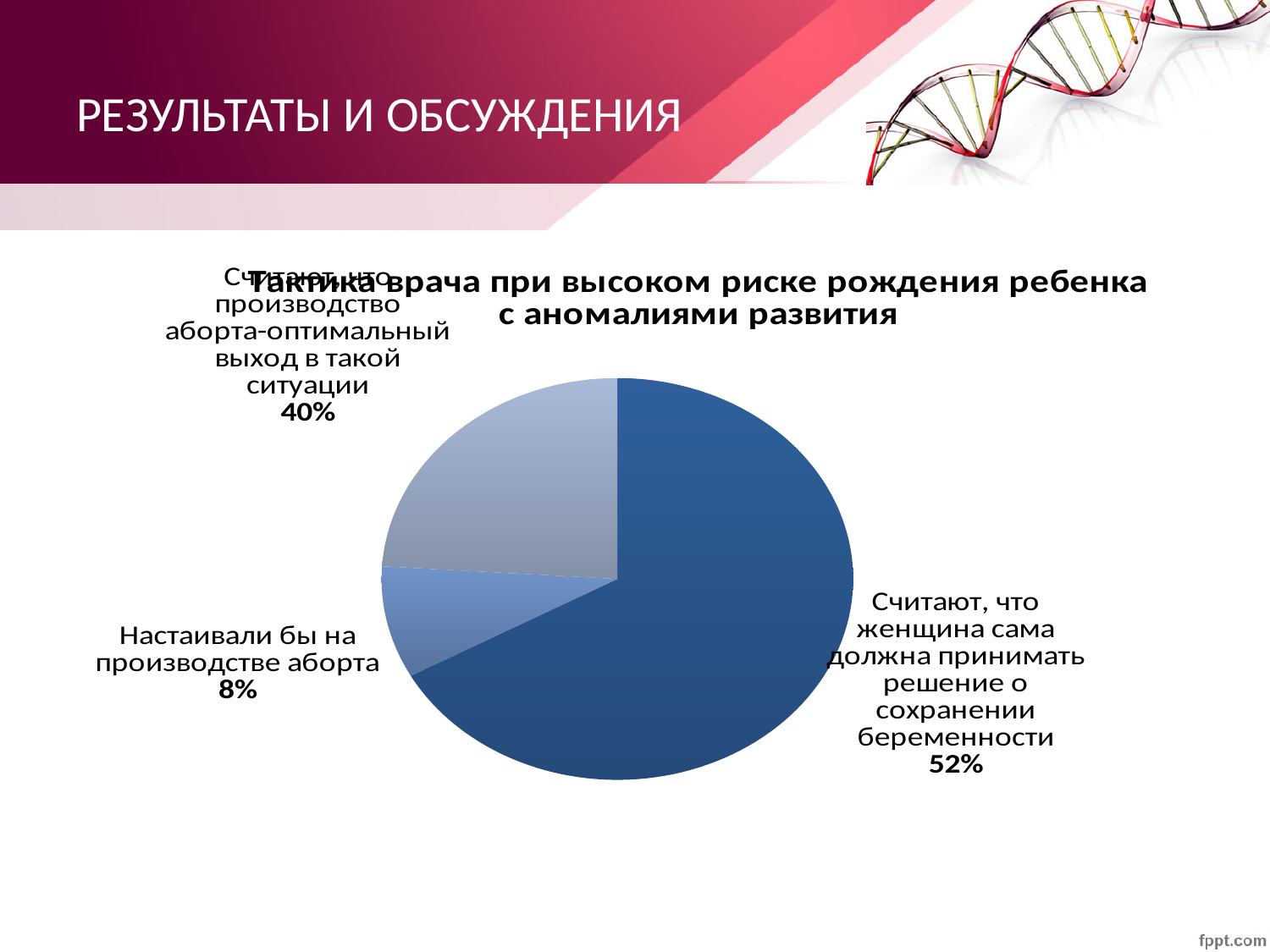
What is the difference in percentage points between the 40% slice and the 8% slice? 32 Which is larger: the share for 'Считают, что женщина сама должна принимать решение о сохранении беременности' or the share for 'Настаивали бы на производстве аборта'? Считают, что женщина сама должна принимать решение о сохранении беременности Which category has the largest share of the pie? Считают, что женщина сама должна принимать решение о сохранении беременности Which category has the smallest share of the pie? Настаивали бы на производстве аборта What percentage is shown for those who consider abortion the optimal way out in such a situation (Считают, что производство аборта-оптимальный выход в такой ситуации)? 40% Is the share for 'Считают, что женщина сама должна принимать решение о сохранении беременности' greater or less than 50%? greater What share of the pie corresponds to those who believe the woman herself should decide whether to keep the pregnancy (Считают, что женщина сама должна принимать решение о сохранении беременности)? 52% What percentage is shown for those who would insist on an abortion (Настаивали бы на производстве аборта)? 8% What kind of chart is shown on the slide? pie chart What is the difference in percentage points between the 52% slice and the 40% slice? 12 How many slices does the pie chart have? 3 What is the title of the chart? Тактика врача при высоком риске рождения ребенка с аномалиями развития